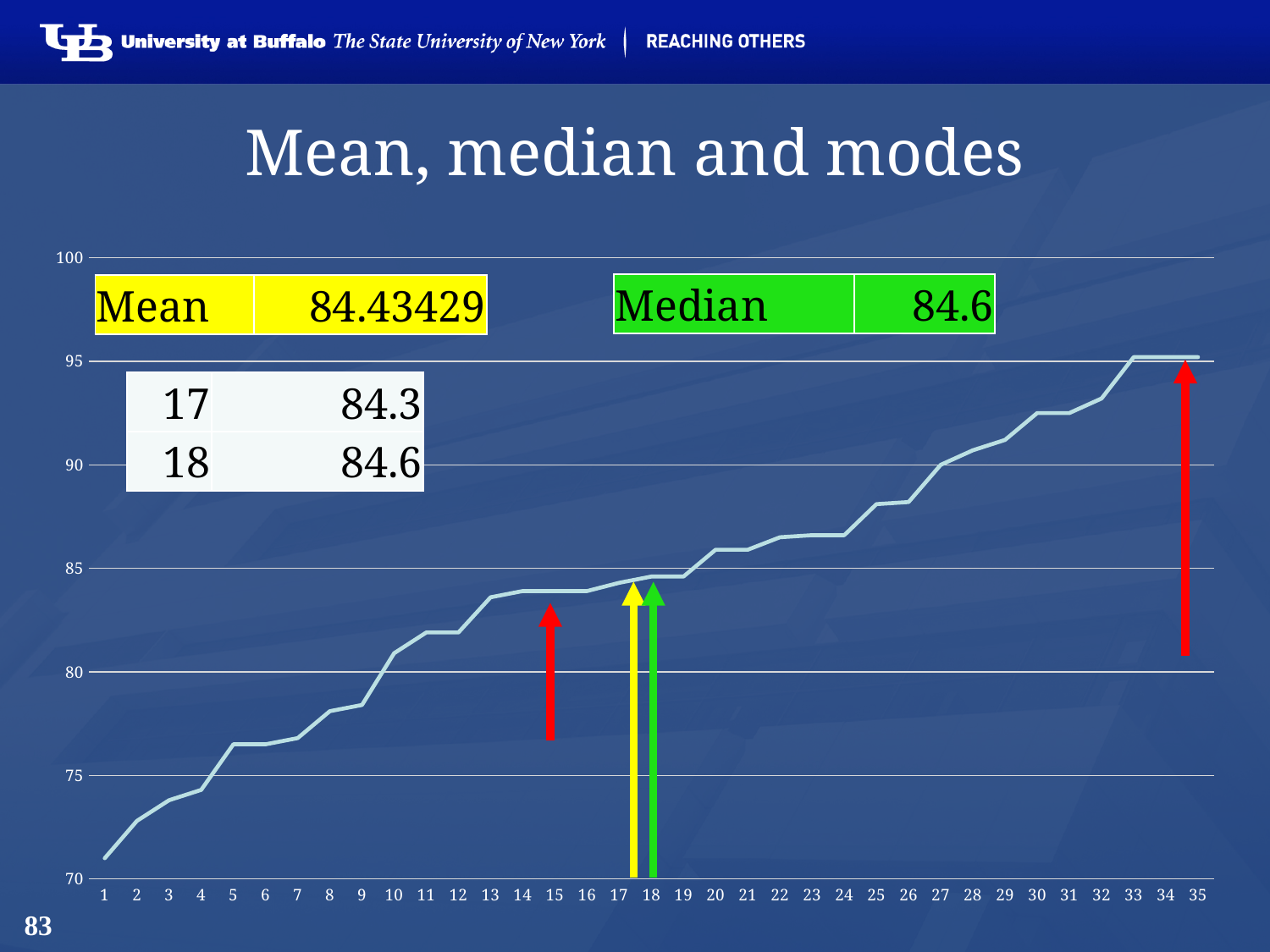
How many data points are plotted along the x axis? 35 Which point has the lowest value on the chart? 1 What kind of chart is shown on the slide? line chart What is the mean value shown on the slide? 84.43429 What is the title of the slide containing the chart? Mean, median and modes What is the value for point 17? 84.3 Is the value for point 1 greater or less than 75? less Is the value for point 30 greater or less than 90? greater What is the value for point 18? 84.6 What is the difference between the values for point 18 and point 17? 0.3 What is the median value shown on the slide? 84.6 Do the plotted values rise or fall as the x axis goes from 1 to 35? rise